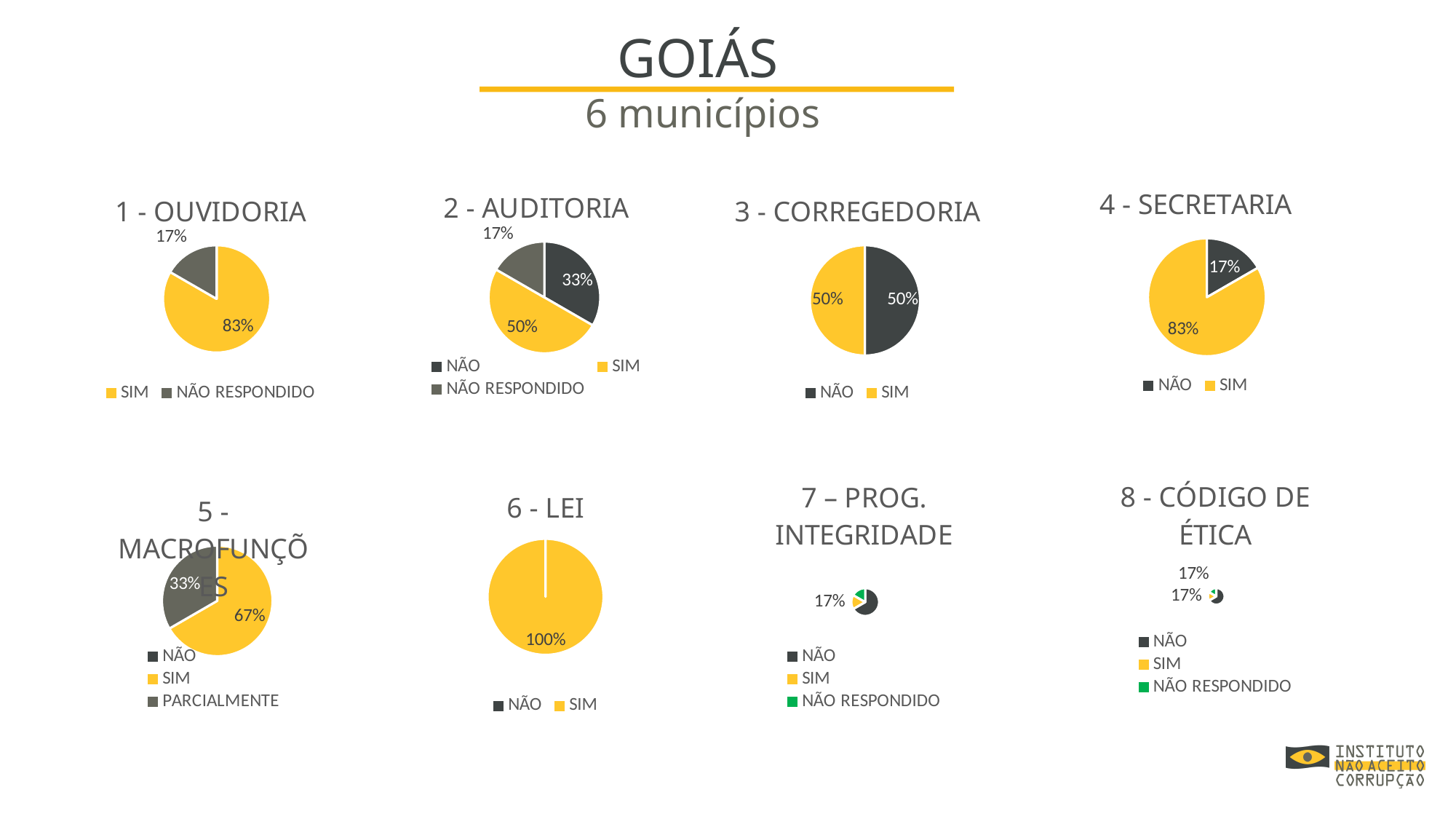
In the '6 - LEI' chart, what percentage is shown for SIM? 100% What type of chart is used for '3 - CORREGEDORIA'? Pie chart In the '4 - SECRETARIA' chart, which is larger, SIM or NÃO? SIM In the '1 - OUVIDORIA' chart, what percentage is shown for SIM? 83% In the '3 - CORREGEDORIA' chart, what percentage is shown for NÃO? 50% How many entries does the legend of the '2 - AUDITORIA' chart list? 3 In the '2 - AUDITORIA' chart, what is the difference between the SIM share and the NÃO RESPONDIDO share? 33% In the '2 - AUDITORIA' chart, what percentage is shown for NÃO? 33% In the '2 - AUDITORIA' chart, which category has the largest share? SIM In the '1 - OUVIDORIA' chart, what percentage is shown for NÃO RESPONDIDO? 17% In the '5 - MACROFUNÇÕES' chart, what percentage is shown for PARCIALMENTE? 33% In the '4 - SECRETARIA' chart, what percentage is shown for SIM? 83%